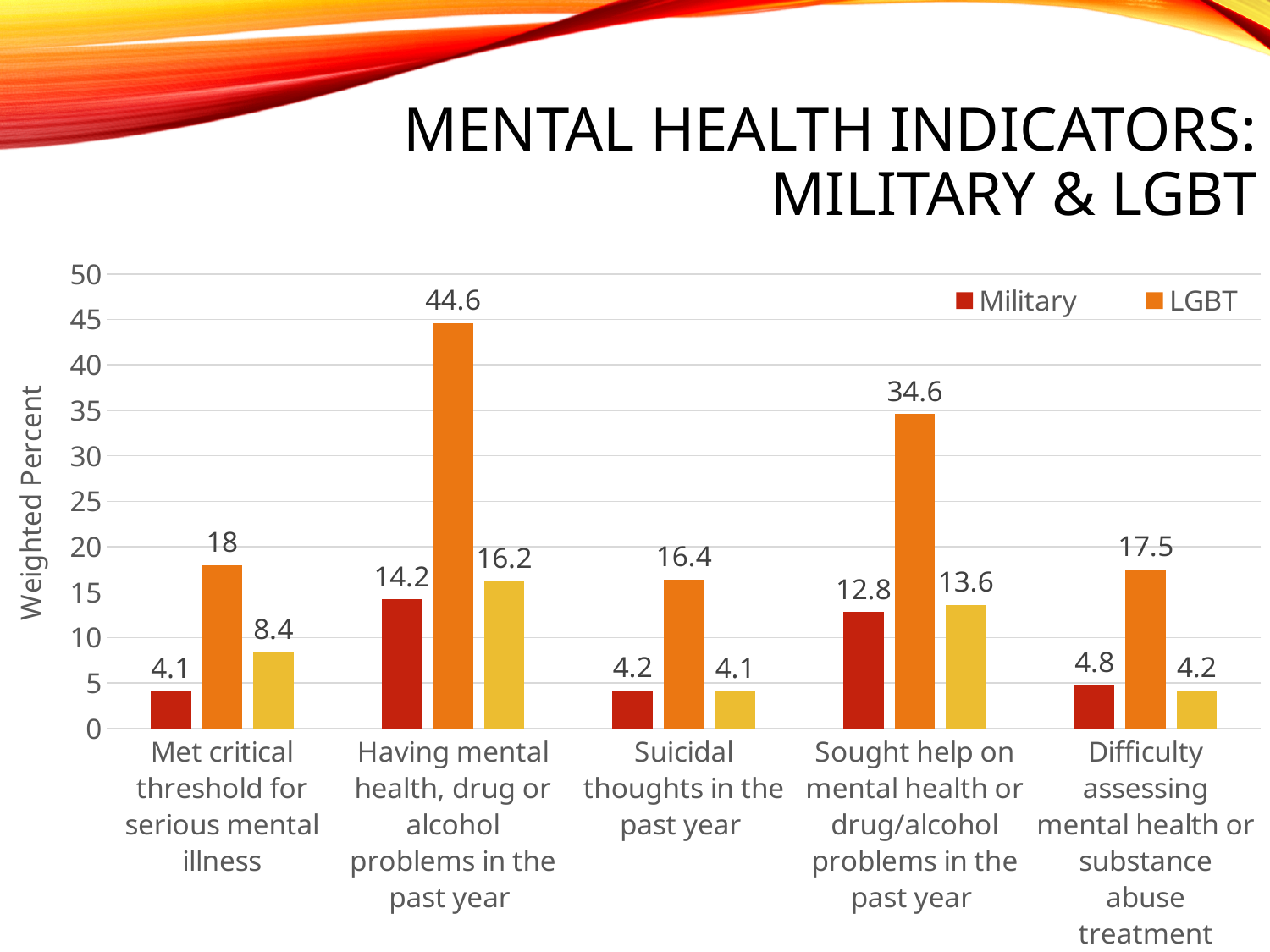
What kind of chart is shown on the slide? Bar chart What is the label of the y axis? Weighted Percent Which is larger: the LGBT value for 'Sought help on mental health or drug/alcohol problems in the past year' or the LGBT value for 'Difficulty assessing mental health or substance abuse treatment'? Sought help on mental health or drug/alcohol problems in the past year What is the LGBT value for 'Having mental health, drug or alcohol problems in the past year'? 44.6 Which category has the highest LGBT value? Having mental health, drug or alcohol problems in the past year What is the Military value for 'Difficulty assessing mental health or substance abuse treatment'? 4.8 Which category has the lowest Military value? Met critical threshold for serious mental illness What is the LGBT value for 'Met critical threshold for serious mental illness'? 18 What is the Military value for 'Sought help on mental health or drug/alcohol problems in the past year'? 12.8 What is the difference between the LGBT and Military values for 'Suicidal thoughts in the past year'? 12.2 How many categories are shown on the x axis? 5 How many series does the legend list? 2